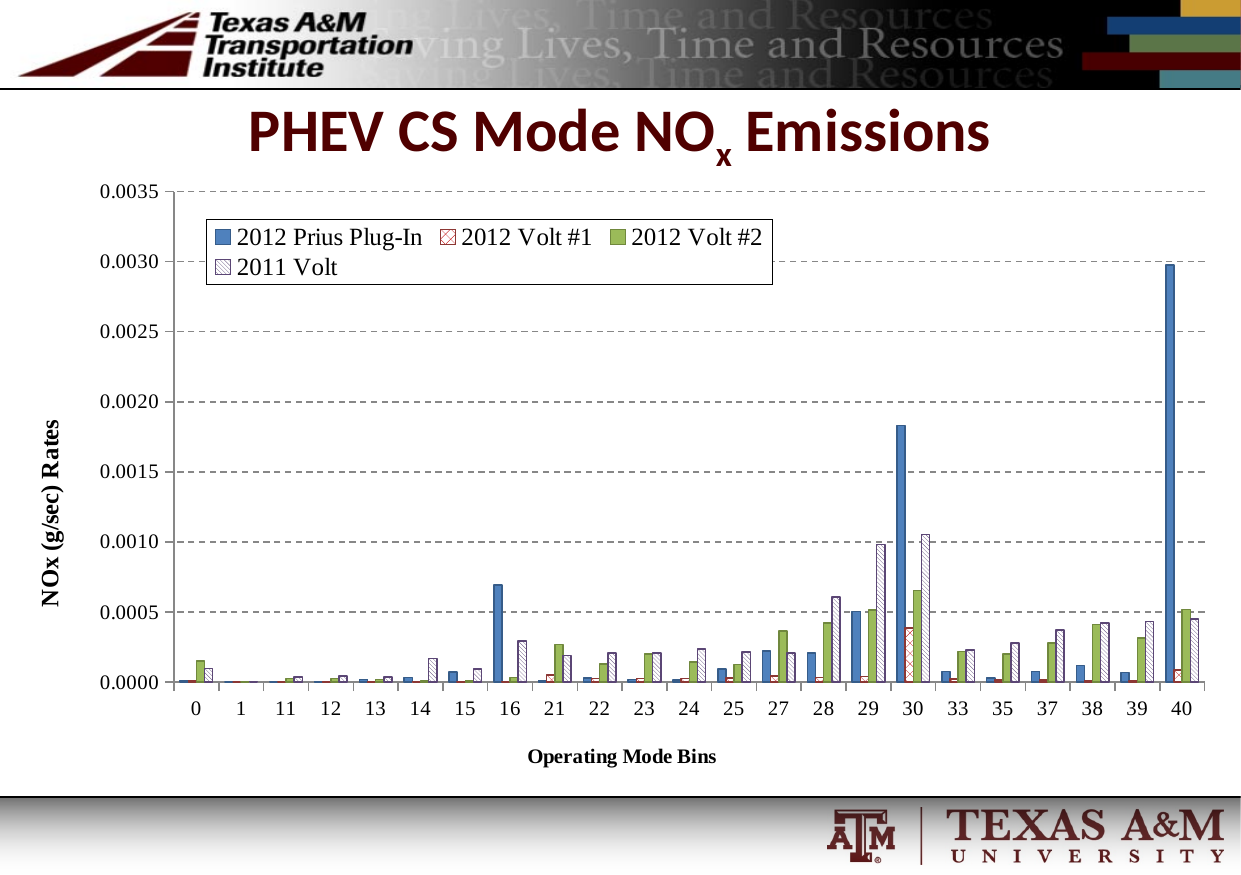
What kind of chart is shown on the slide? bar chart How many series does the legend list? 4 What is the label of the y axis? NOx (g/sec) Rates Is the 2012 Prius Plug-In value at bin 16 greater or less than 0.0005? greater At bin 28, which series has the larger value: 2012 Prius Plug-In or 2011 Volt? 2011 Volt How many operating mode bins are shown on the x axis? 23 Is the 2012 Volt #2 value at bin 30 greater or less than 0.0005? greater Is the 2012 Prius Plug-In value at bin 30 greater or less than 0.0015? greater In which operating mode bin is the 2012 Volt #2 value highest? 30 Which is larger for the 2012 Prius Plug-In: the value at bin 30 or the value at bin 40? bin 40 In which operating mode bin is the 2012 Prius Plug-In value highest? 40